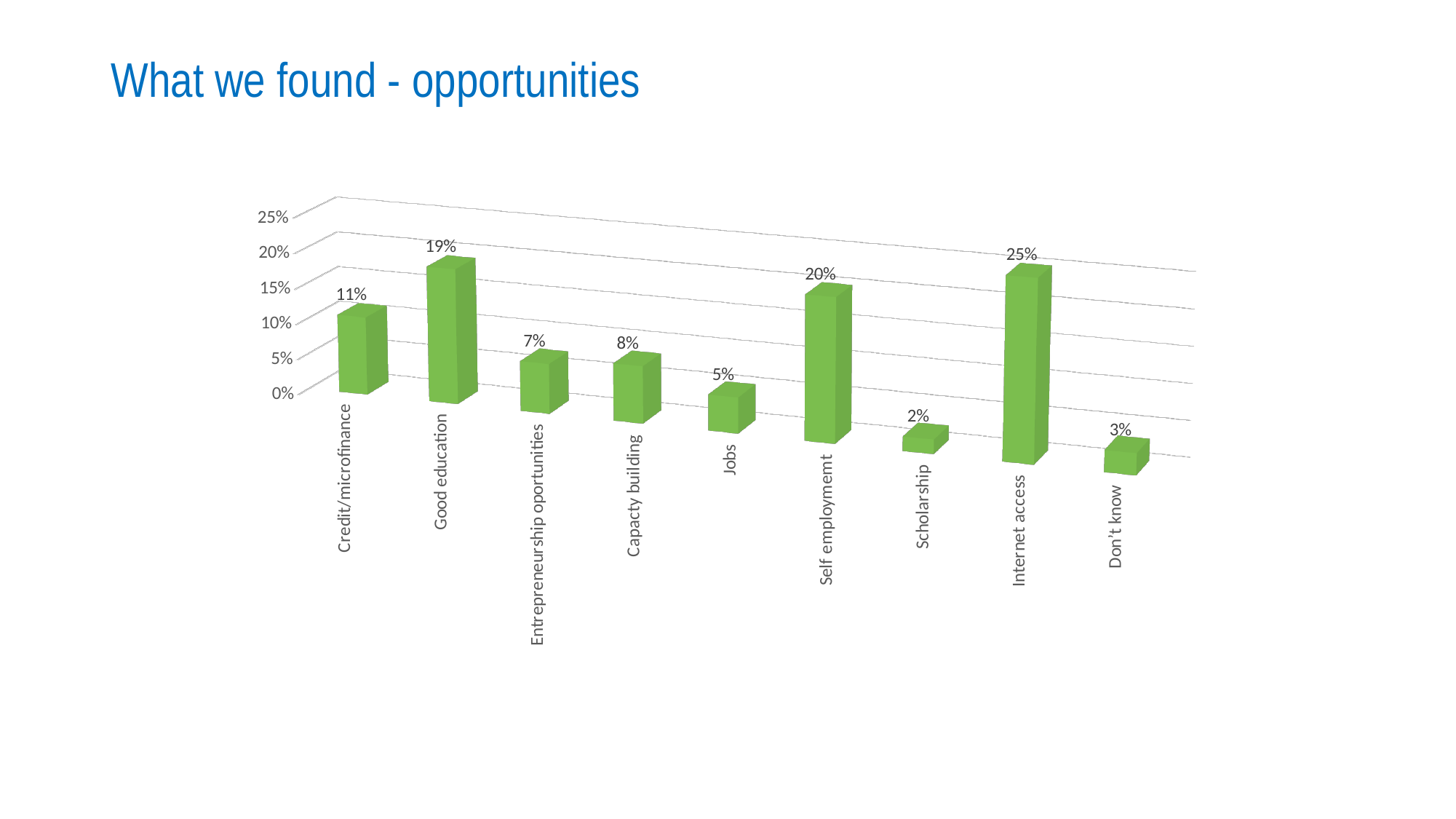
Which category has the lowest value? Scholarship What is the value for Internet access? 25% Which is larger, the value for Good education or the value for Self employmemt? Self employmemt Which category has the highest value? Internet access What is the value for Scholarship? 2% What is the value for Self employmemt? 20% What is the title of the slide? What we found - opportunities What is the difference between the values for Capacty building and Jobs? 3% What kind of chart is shown on the slide? Bar chart How many categories are shown on the chart? 9 What is the value for Good education? 19% What is the difference between the values for Internet access and Credit/microfinance? 14%